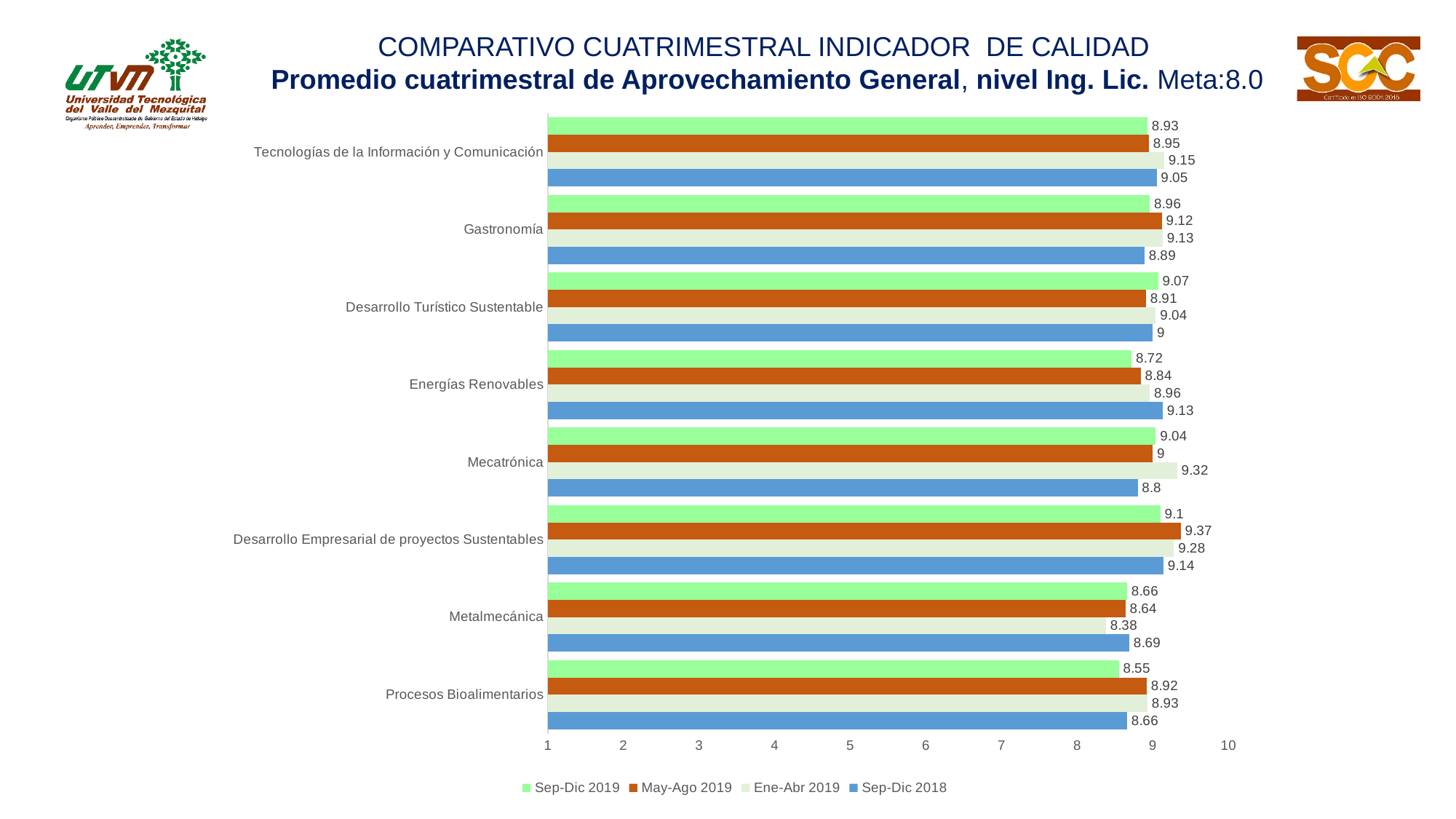
Which category has the highest Ene-Abr 2019 value? Mecatrónica Which is larger for Procesos Bioalimentarios: the Sep-Dic 2019 value or the May-Ago 2019 value? May-Ago 2019 Which category has the highest May-Ago 2019 value? Desarrollo Empresarial de proyectos Sustentables What kind of chart is shown on the slide? Bar chart What is the target (Meta) stated in the chart title? 8.0 How many categories (programs) are shown on the chart? 8 What is the Ene-Abr 2019 value for Metalmecánica? 8.38 Which category has the lowest Sep-Dic 2019 value? Procesos Bioalimentarios How many series does the legend list? 4 What is the Sep-Dic 2018 value for Energías Renovables? 9.13 What is the Sep-Dic 2019 value for Mecatrónica? 9.04 What is the difference between the Ene-Abr 2019 and Sep-Dic 2018 values for Mecatrónica? 0.52